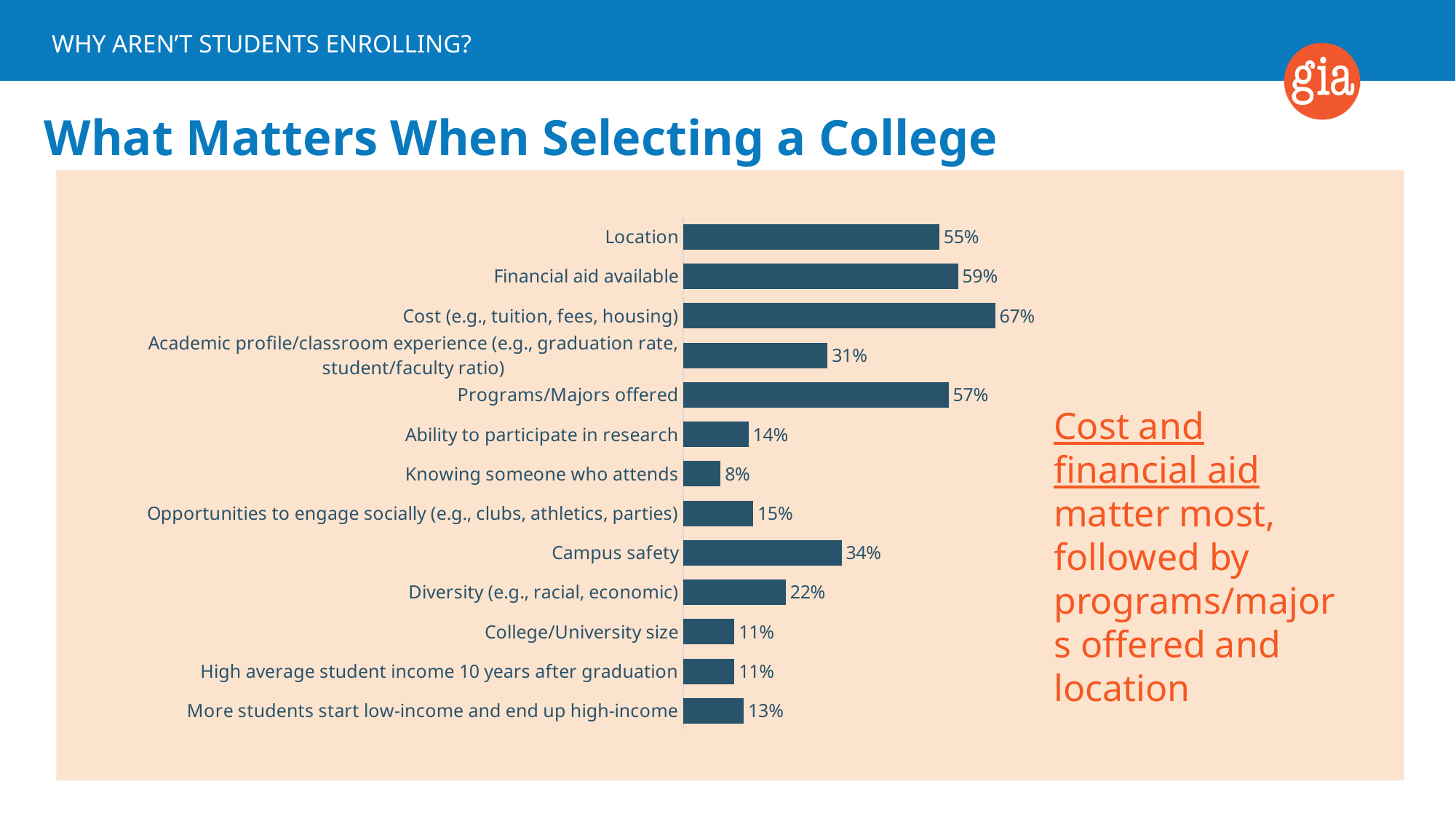
Which category has the lowest value? Knowing someone who attends What is the difference between the values for Cost (e.g., tuition, fees, housing) and Programs/Majors offered? 10% What percentage is shown for Knowing someone who attends? 8% Which is larger, the value for Programs/Majors offered or the value for Location? Programs/Majors offered What percentage is shown for Campus safety? 34% Which category has the highest value? Cost (e.g., tuition, fees, housing) What is the difference between the values for Financial aid available and Location? 4% How many categories are shown in the chart? 13 What is the title of the slide above the chart? What Matters When Selecting a College What kind of chart is shown on the slide? Bar chart What percentage is shown for Cost (e.g., tuition, fees, housing)? 67% Which is larger, the value for Campus safety or the value for Diversity (e.g., racial, economic)? Campus safety